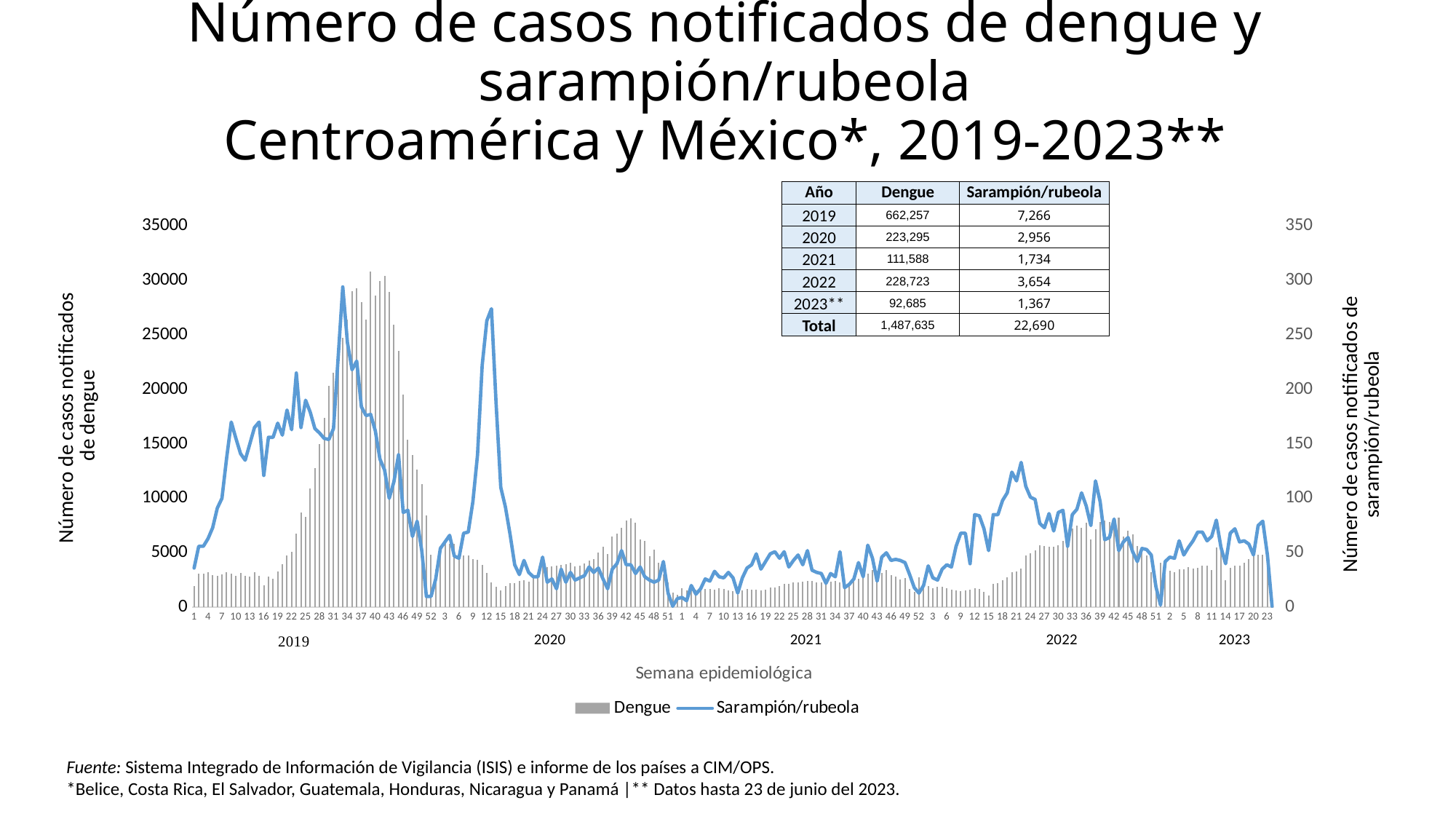
Is the peak of the sarampión/rubeola line in 2020 greater or less than 200? greater According to the table on the chart, how many sarampión/rubeola cases were notified in 2022? 3,654 According to the table on the chart, how many dengue cases were notified in 2019? 662,257 How many series does the chart legend list? 2 Is the highest weekly dengue bar in 2019 greater or less than 25000? greater In the table, which year has the highest number of dengue cases? 2019 Using the table, what is the difference between dengue cases in 2020 and 2021? 111,707 In the table, which year has the lowest number of sarampión/rubeola cases? 2023** According to the table, which year had more dengue cases, 2020 or 2022? 2022 What kind of chart is used to show the dengue and sarampión/rubeola cases? Bar and line chart What is the label of the x axis of the chart? Semana epidemiológica What is the total number of dengue cases shown in the table? 1,487,635